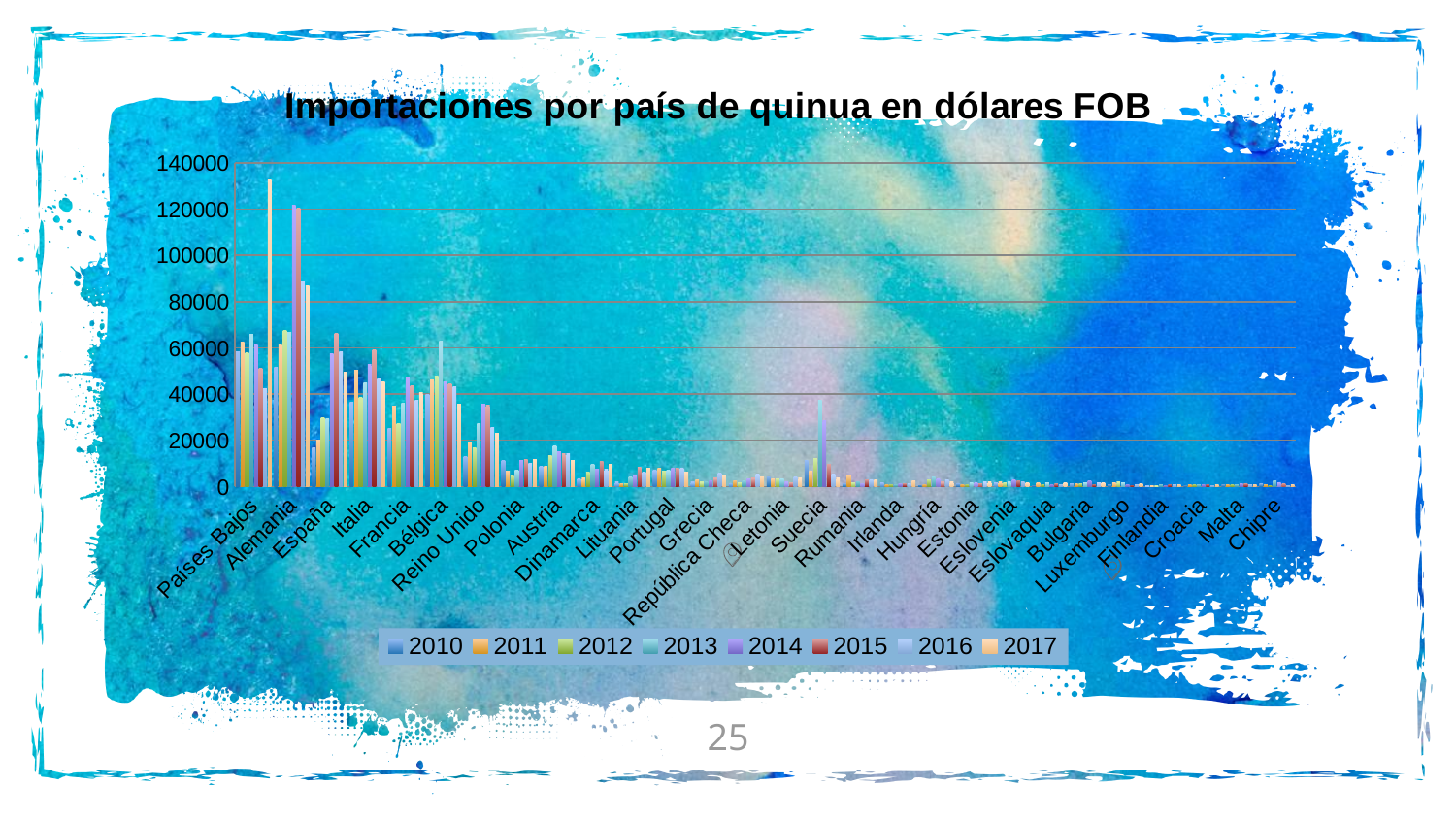
Are all the bars for Polonia greater or less than 20000? less Is the tallest bar for Bélgica greater or less than 40000? greater Are all the bars for Chipre greater or less than 20000? less Which years are listed in the legend? 2010, 2011, 2012, 2013, 2014, 2015, 2016, 2017 What is the title of the chart? Importaciones por país de quinua en dólares FOB What kind of chart is shown on the slide? bar chart Which country has the higher tallest bar, Países Bajos or Alemania? Países Bajos Do the import values generally rise or fall moving from left to right along the x axis? fall Which country has the tallest bar in the chart? Países Bajos How many series does the legend list? 8